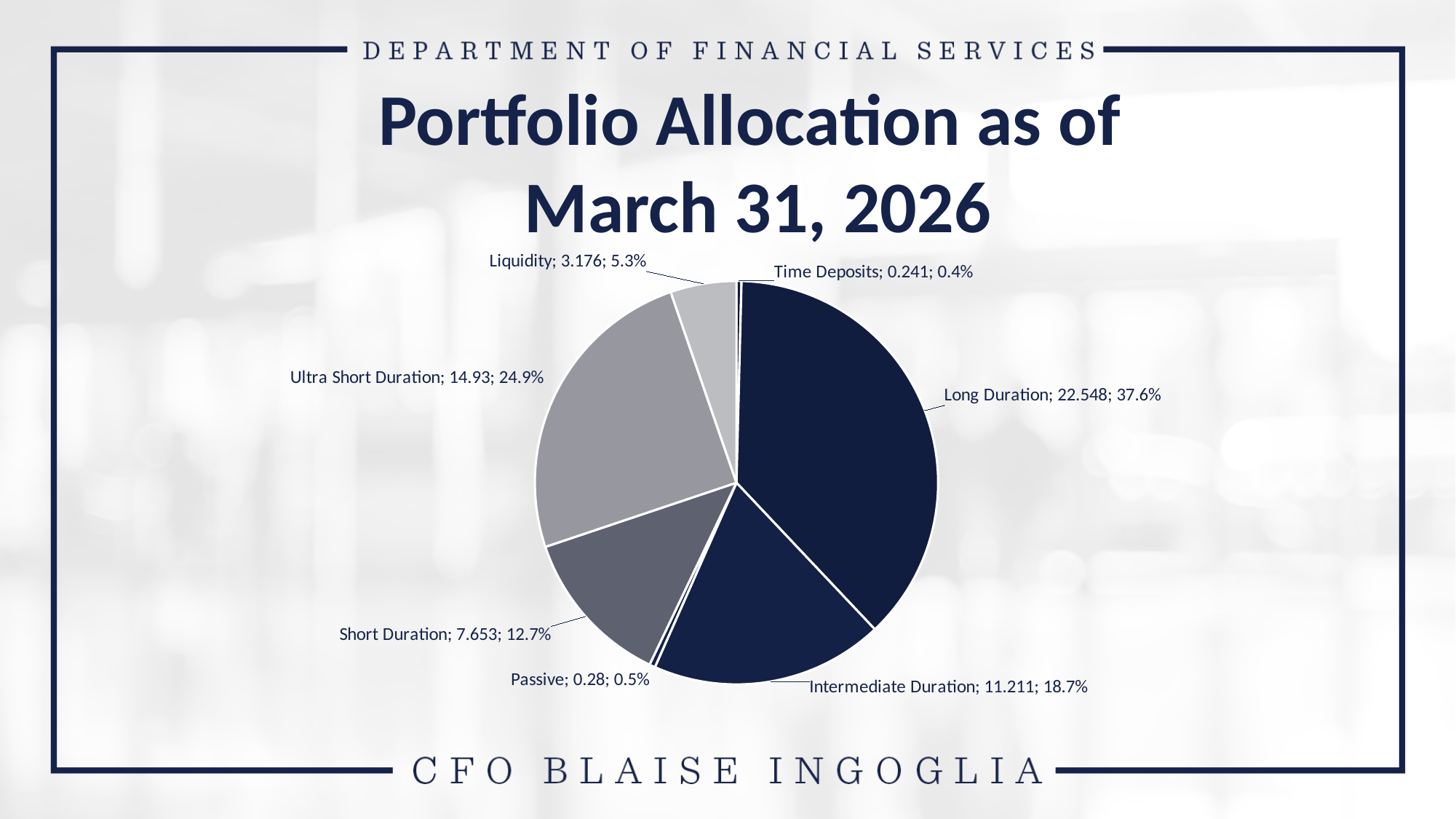
Which category has the smallest slice? Time Deposits What is the value for Intermediate Duration? 11.211 What kind of chart is shown on the slide? Pie chart What is the title of the chart? Portfolio Allocation as of March 31, 2026 What is the value for Long Duration? 22.548 What is the value for Passive? 0.28 What percentage share does Liquidity have? 5.3% How many categories are shown in the pie chart? 7 Which is larger, Short Duration or Ultra Short Duration? Ultra Short Duration What is the difference in percentage share between Long Duration and Intermediate Duration? 18.9% What percentage share does Ultra Short Duration have? 24.9% Which category has the largest slice? Long Duration